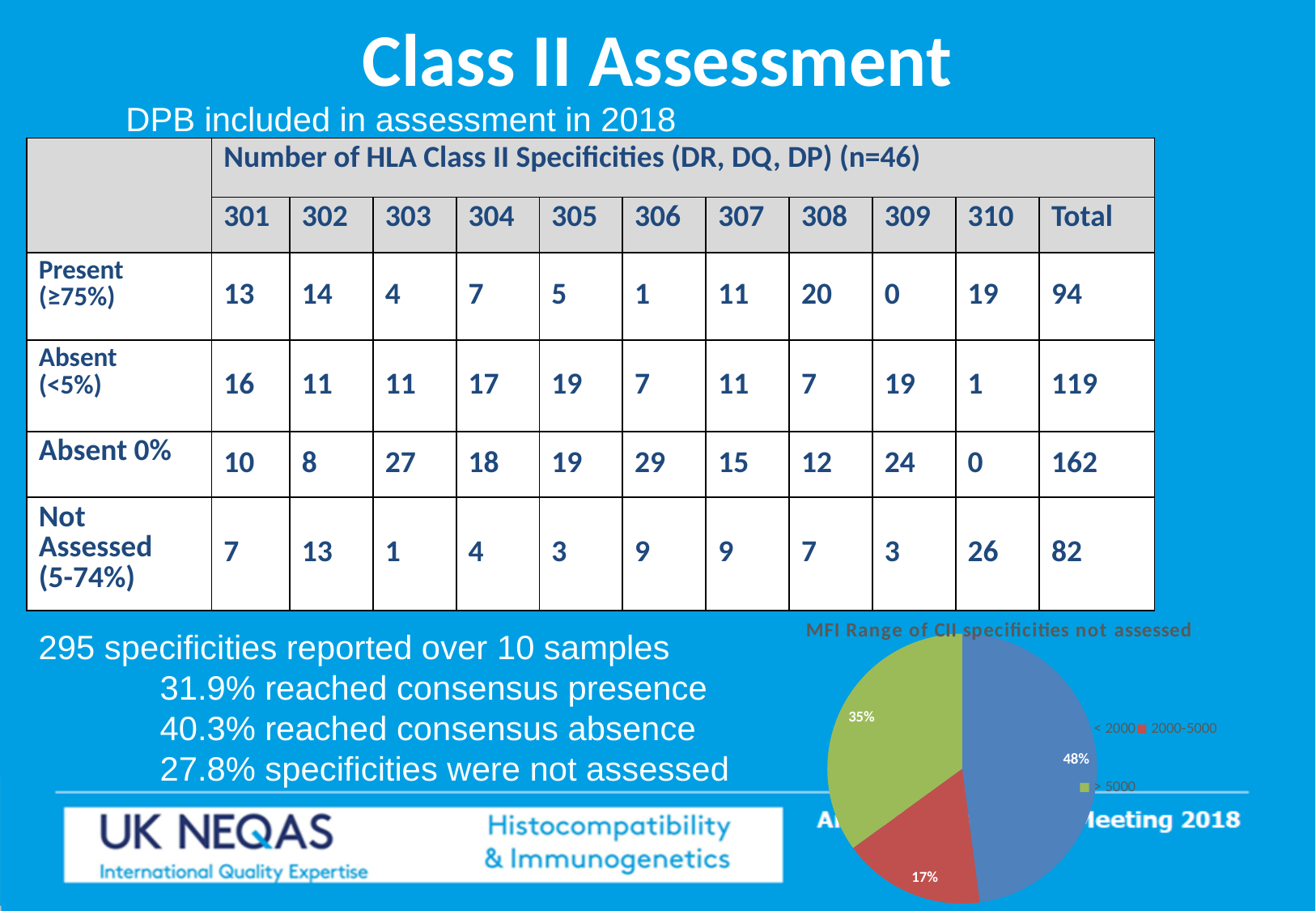
How many slices does the pie chart have? 3 In the pie chart, what is the difference in percentage points between the < 2000 slice and the > 5000 slice? 13 How many entries does the pie chart legend list? 3 What colour is the 2000-5000 slice in the pie chart? red Which MFI range has the smallest slice in the pie chart? 2000-5000 What is the title of the pie chart? MFI Range of CII specificities not assessed In the pie chart, what share is labelled on the red slice (2000-5000)? 17% In the pie chart, what share is labelled on the green slice (> 5000)? 35% In the pie chart, what share is labelled on the blue slice (< 2000)? 48% In the pie chart, which slice is larger: > 5000 or 2000-5000? > 5000 What kind of chart is shown on the slide? pie chart Which MFI range has the largest slice in the pie chart? < 2000